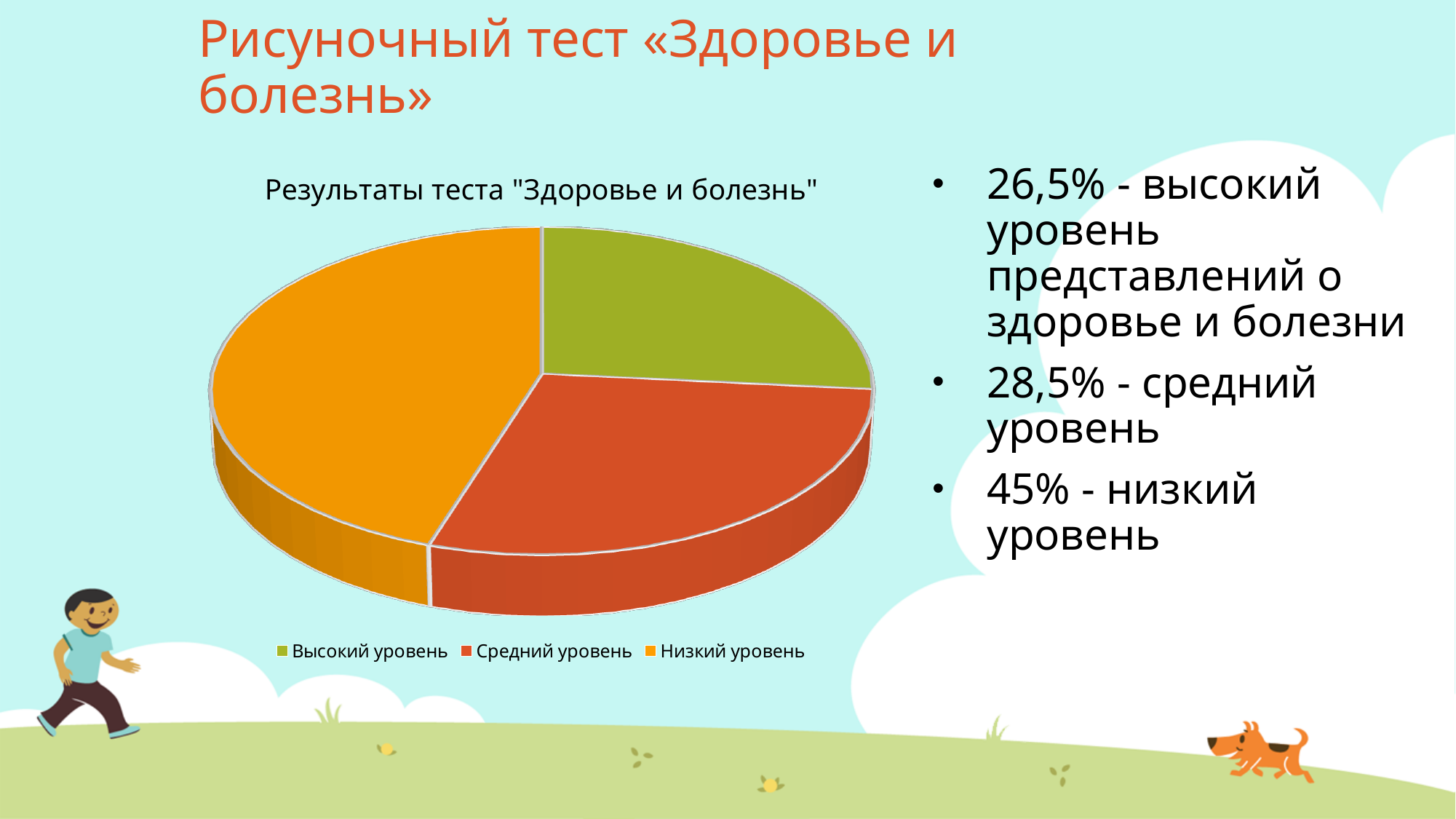
What share of the pie does Средний уровень take? 28,5% What is the difference between the share for Низкий уровень and the share for Высокий уровень? 18,5% How many slices does the pie chart have? 3 What share of the pie does Высокий уровень take? 26,5% What kind of chart is shown on the slide? Pie chart What share of the pie does Низкий уровень take? 45% Which is larger, the slice for Низкий уровень or the slice for Высокий уровень? Низкий уровень What colour is the slice for Низкий уровень? Orange How many entries does the chart legend list? 3 Which category has the largest slice of the pie? Низкий уровень What is the title of the chart? Результаты теста "Здоровье и болезнь"